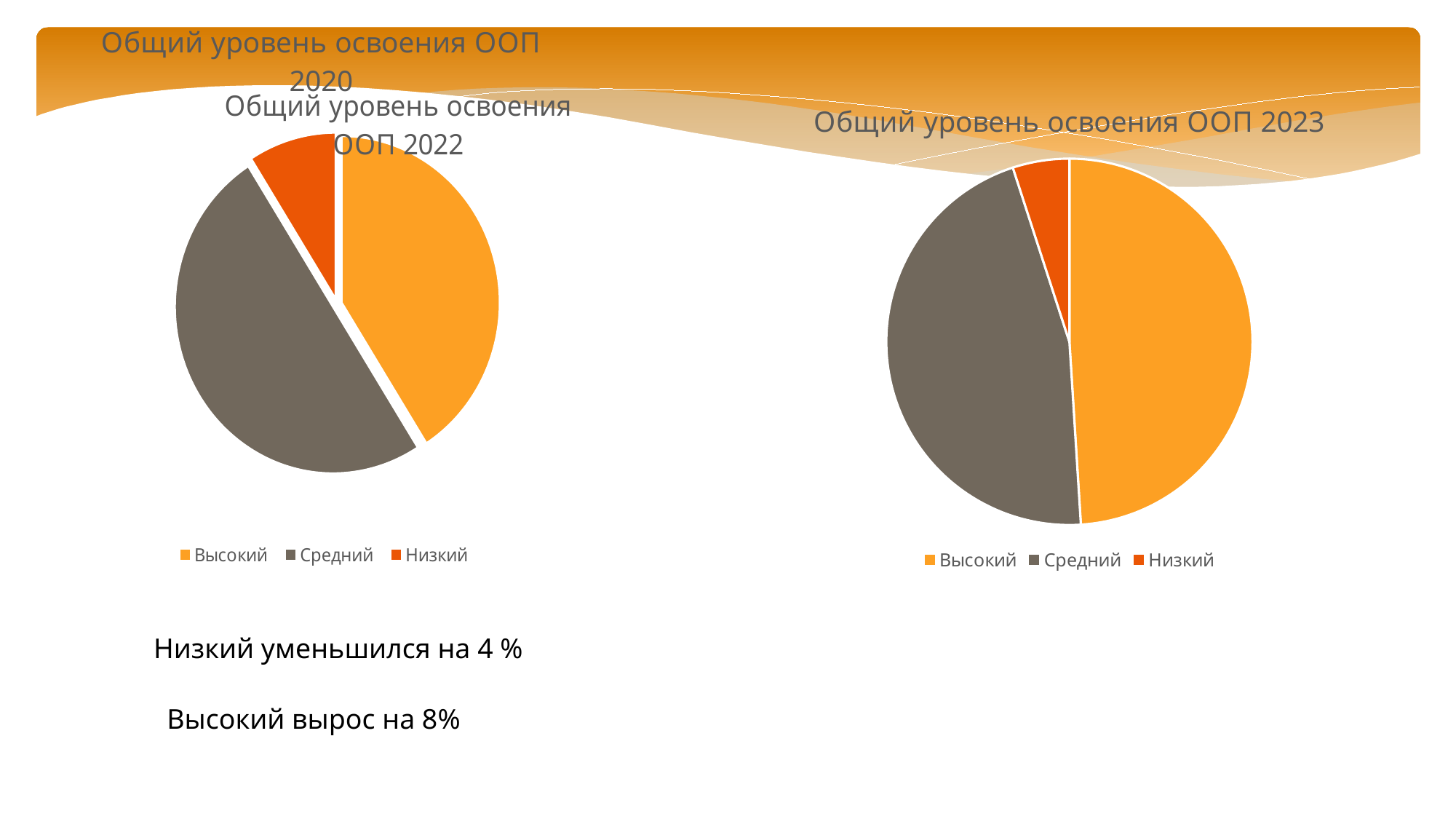
In the chart titled "Общий уровень освоения ООП 2023", which slice is larger, Высокий or Низкий? Высокий What are the legend entries of the chart titled "Общий уровень освоения ООП 2023"? Высокий, Средний, Низкий How many entries does the legend of the chart titled "Общий уровень освоения ООП 2023" list? 3 What kind of chart is the chart on the left side of the slide? pie chart In the chart on the left side of the slide, which slice is larger, Высокий or Средний? Средний In the chart on the left side of the slide, which category has the smallest slice? Низкий In the chart on the left side of the slide, how many slices does the pie have? 3 In the chart titled "Общий уровень освоения ООП 2023", what colour is the Средний slice? grey In the chart titled "Общий уровень освоения ООП 2023", which category has the smallest slice? Низкий In the chart titled "Общий уровень освоения ООП 2023", how many slices does the pie have? 3 What kind of chart is the chart titled "Общий уровень освоения ООП 2023"? pie chart